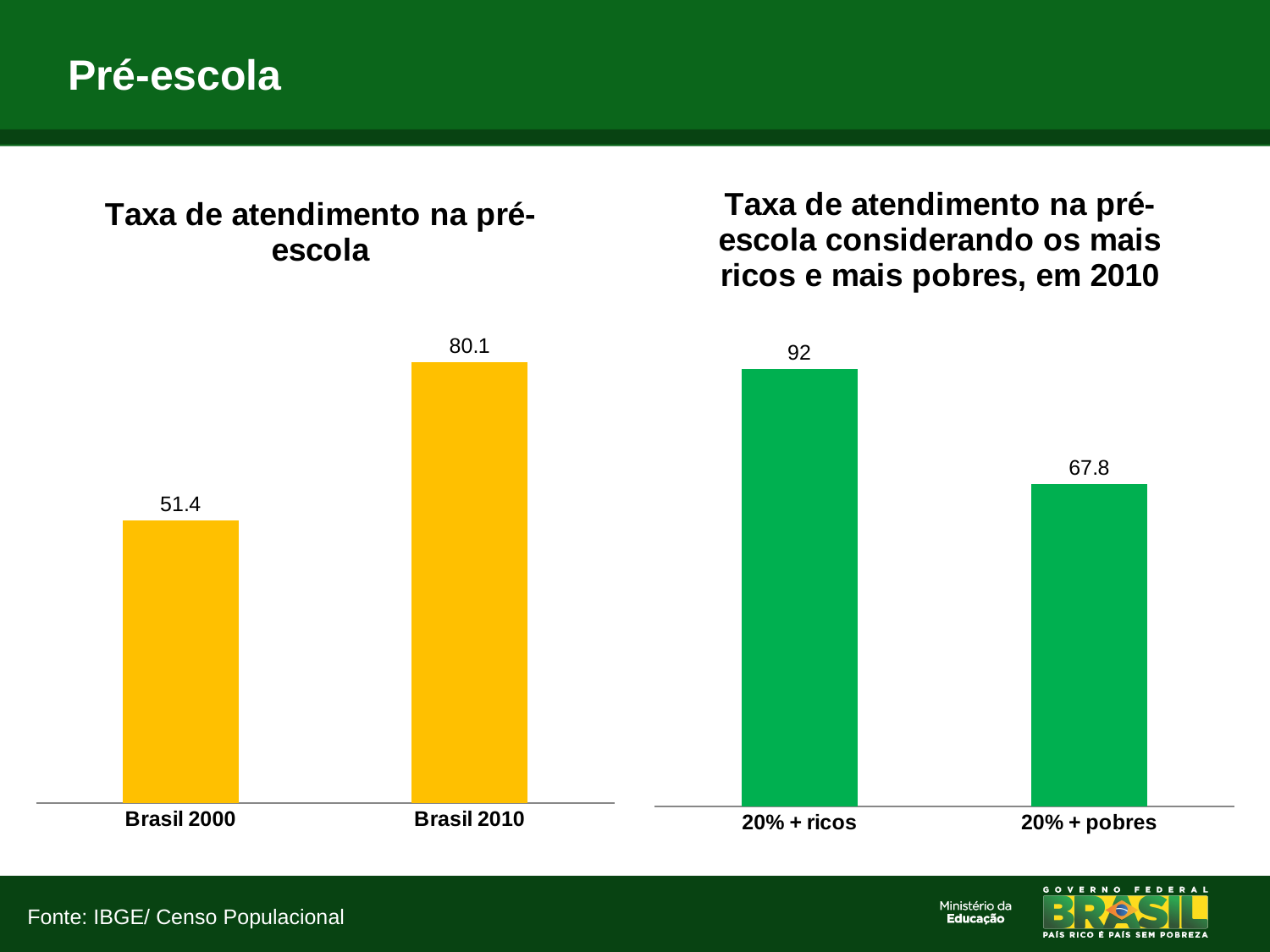
In the left chart 'Taxa de atendimento na pré-escola', do the values rise or fall from Brasil 2000 to Brasil 2010? rise How many categories are shown in the left chart 'Taxa de atendimento na pré-escola'? 2 In the left chart 'Taxa de atendimento na pré-escola', what is the value for Brasil 2010? 80.1 In the right chart 'Taxa de atendimento na pré-escola considerando os mais ricos e mais pobres, em 2010', which is larger: the value for 20% + ricos or for 20% + pobres? 20% + ricos In the left chart 'Taxa de atendimento na pré-escola', which category has the highest value? Brasil 2010 In the right chart 'Taxa de atendimento na pré-escola considerando os mais ricos e mais pobres, em 2010', what is the difference between the values for 20% + ricos and 20% + pobres? 24.2 In the right chart 'Taxa de atendimento na pré-escola considerando os mais ricos e mais pobres, em 2010', what is the value for 20% + ricos? 92 What kind of chart is the right chart 'Taxa de atendimento na pré-escola considerando os mais ricos e mais pobres, em 2010'? bar chart In the right chart 'Taxa de atendimento na pré-escola considerando os mais ricos e mais pobres, em 2010', which category has the lowest value? 20% + pobres In the left chart 'Taxa de atendimento na pré-escola', what is the value for Brasil 2000? 51.4 In the right chart 'Taxa de atendimento na pré-escola considerando os mais ricos e mais pobres, em 2010', what is the value for 20% + pobres? 67.8 In the left chart 'Taxa de atendimento na pré-escola', what is the difference between the values for Brasil 2010 and Brasil 2000? 28.7